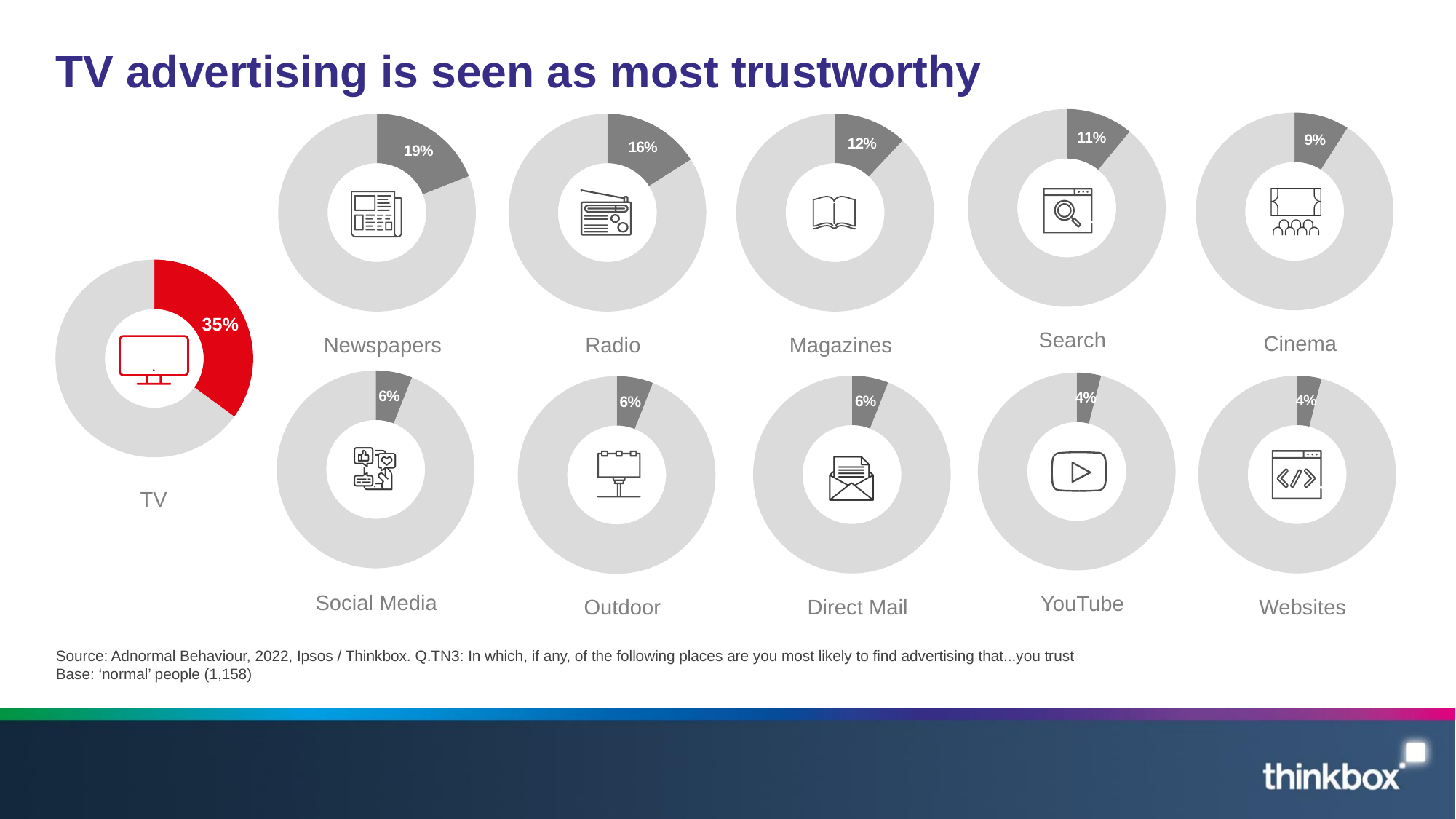
How many media categories are shown on the slide? 11 What is the difference in percentage points between Magazines and Search? 1 What percentage is shown for Cinema? 9% Which medium's chart is highlighted in red? TV What percentage is shown for Radio? 16% What percentage is shown for TV? 35% Which has a higher percentage, Cinema or YouTube? Cinema Which has a higher percentage, Radio or Magazines? Radio Which medium has the highest percentage on the slide? TV What kind of chart is used for each medium on the slide? Donut (pie) chart What is the difference in percentage points between TV and Newspapers? 16 What percentage is shown for Newspapers? 19%